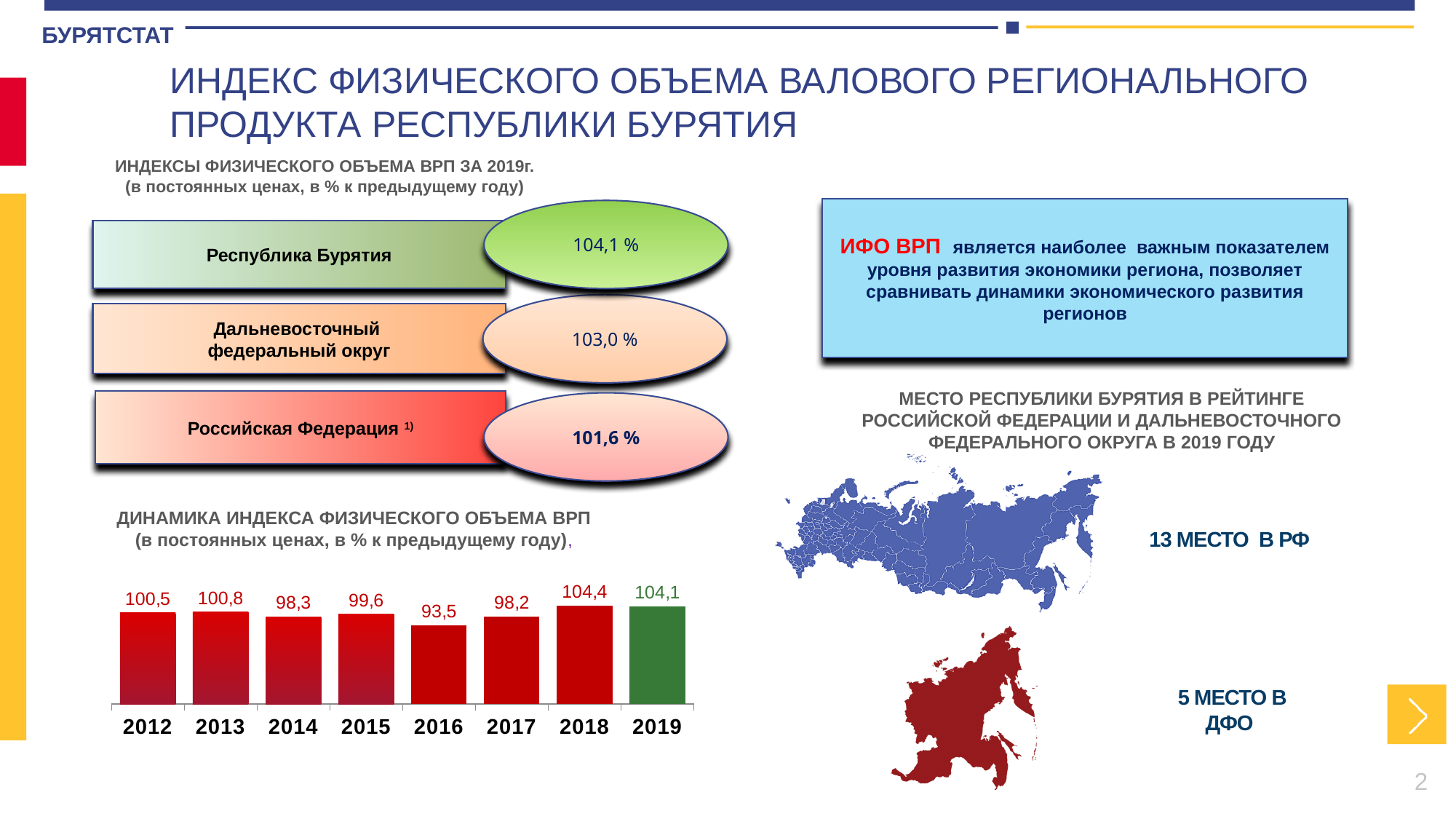
In the bar chart 'ДИНАМИКА ИНДЕКСА ФИЗИЧЕСКОГО ОБЪЕМА ВРП', which year's bar is coloured green instead of red? 2019 In the bar chart 'ДИНАМИКА ИНДЕКСА ФИЗИЧЕСКОГО ОБЪЕМА ВРП', which year has the highest value? 2018 In the bar chart 'ДИНАМИКА ИНДЕКСА ФИЗИЧЕСКОГО ОБЪЕМА ВРП', which year has the lowest value? 2016 In the bar chart 'ДИНАМИКА ИНДЕКСА ФИЗИЧЕСКОГО ОБЪЕМА ВРП', what is the difference between the values for 2019 and 2012? 3,6 In the bar chart 'ДИНАМИКА ИНДЕКСА ФИЗИЧЕСКОГО ОБЪЕМА ВРП', do the values rise or fall from 2016 to 2018? rise In the bar chart 'ДИНАМИКА ИНДЕКСА ФИЗИЧЕСКОГО ОБЪЕМА ВРП', what is the difference between the values for 2018 and 2016? 10,9 In the bar chart 'ДИНАМИКА ИНДЕКСА ФИЗИЧЕСКОГО ОБЪЕМА ВРП', what is the value for 2016? 93,5 How many years are shown in the bar chart 'ДИНАМИКА ИНДЕКСА ФИЗИЧЕСКОГО ОБЪЕМА ВРП'? 8 What kind of chart is 'ДИНАМИКА ИНДЕКСА ФИЗИЧЕСКОГО ОБЪЕМА ВРП'? bar chart In the bar chart 'ДИНАМИКА ИНДЕКСА ФИЗИЧЕСКОГО ОБЪЕМА ВРП', what is the value for 2014? 98,3 In the bar chart 'ДИНАМИКА ИНДЕКСА ФИЗИЧЕСКОГО ОБЪЕМА ВРП', what is the value for 2019? 104,1 In the bar chart 'ДИНАМИКА ИНДЕКСА ФИЗИЧЕСКОГО ОБЪЕМА ВРП', which is larger, the value for 2015 or the value for 2017? 2015